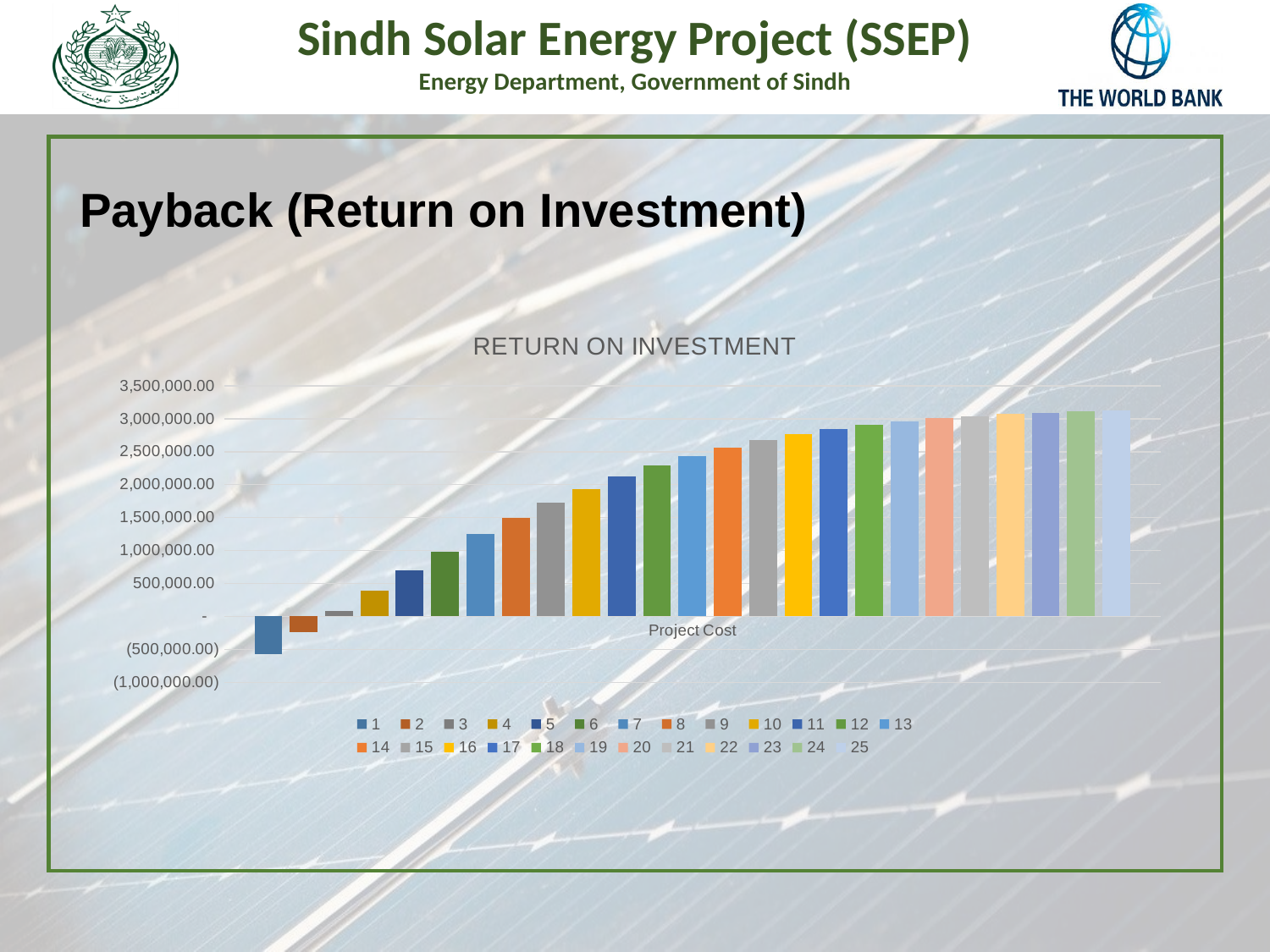
Which is larger, the value for series 2 or the value for series 10? 10 What is the title of the chart? RETURN ON INVESTMENT Is the value for series 7 greater or less than 1,500,000.00? less Is the value for series 5 greater or less than 500,000.00? greater What is the category label shown on the x axis of the chart? Project Cost How many series does the chart legend list? 25 What kind of chart is shown on the slide? bar chart Is the value for series 13 greater or less than 2,000,000.00? greater Do the values rise or fall as the series number increases from 1 to 25? rise Which series has the lowest value in the chart? 1